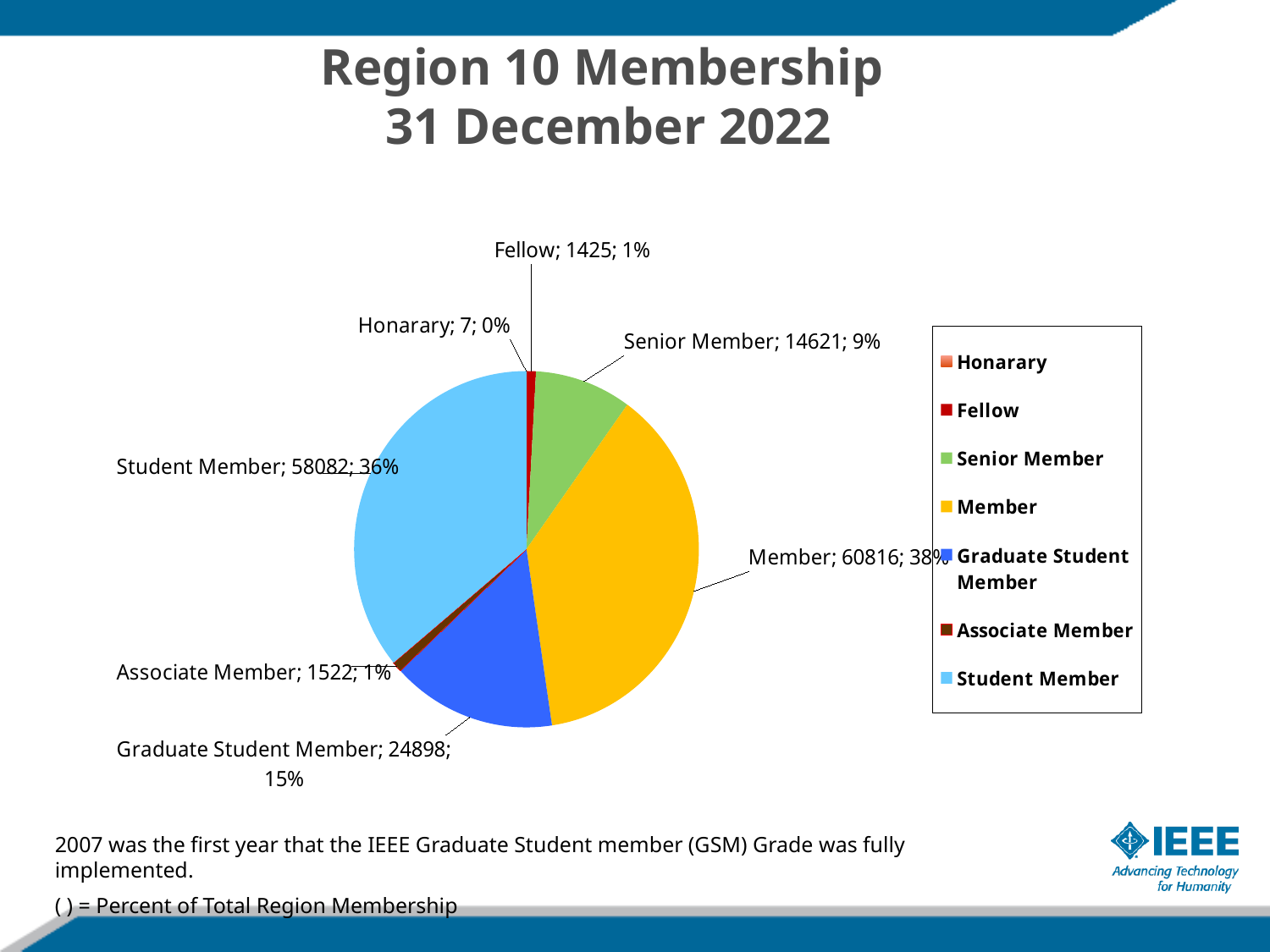
What is the title of the slide containing the chart? Region 10 Membership 31 December 2022 Which is larger, the number of Senior Members or the number of Graduate Student Members? Graduate Student Member Which membership grade has the largest slice of the pie? Member What percentage of Region 10 membership is Senior Member? 9% What percentage of Region 10 membership is Student Member? 36% How many Fellows are shown in the chart? 1425 What type of chart is shown on the slide? pie chart How many membership categories are shown in the pie chart? 7 How many Graduate Student Members are shown? 24898 Which membership grade has the smallest slice of the pie? Honarary How many members does the Member category have? 60816 What is the difference between the number of Members and the number of Student Members? 2734